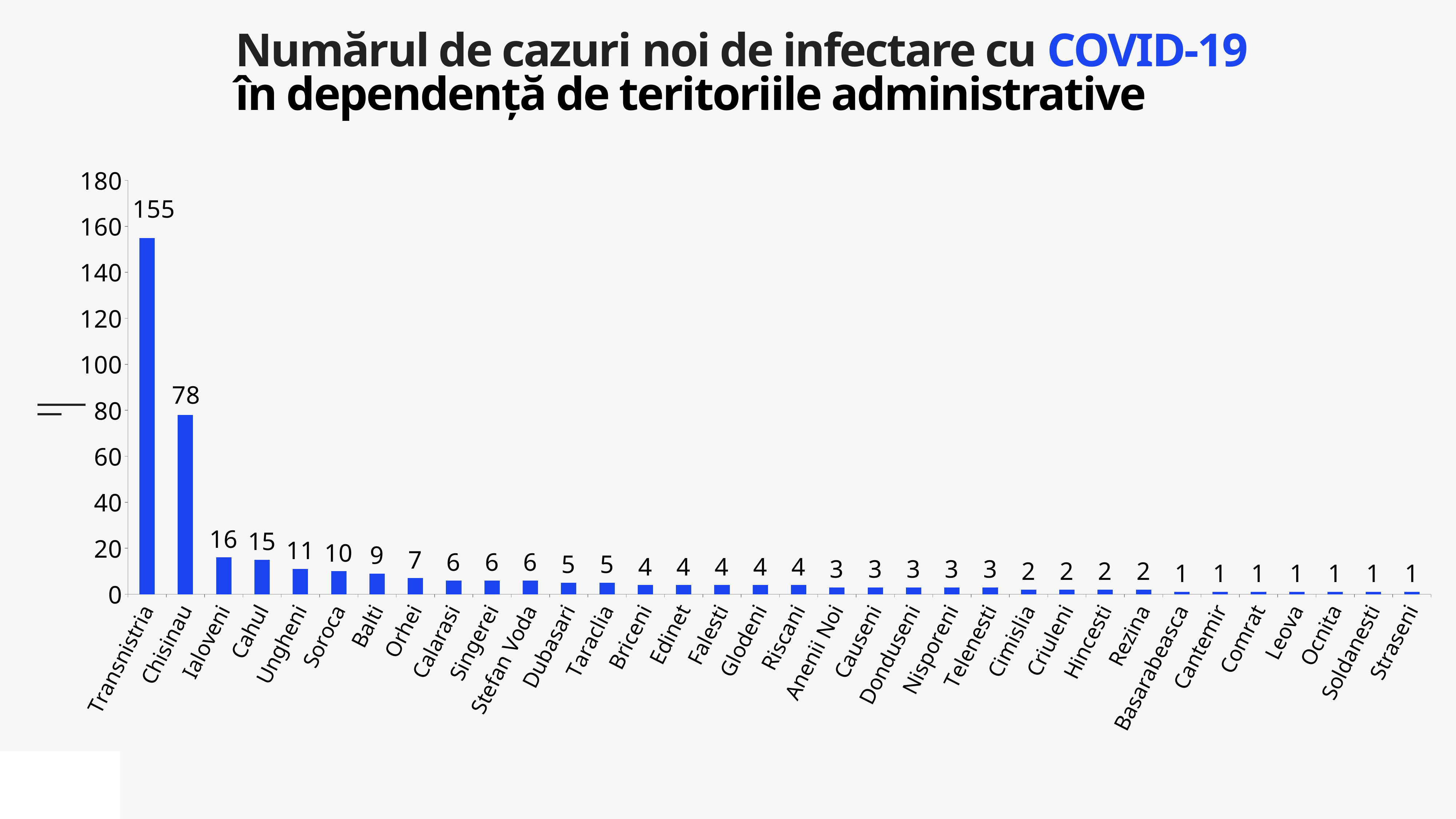
What kind of chart is shown on the slide? bar chart How many territories are shown on the x axis? 34 What is the value for Ialoveni? 16 What is the value for Balti? 9 How many new cases are shown for Chisinau? 78 How many new cases are shown for Transnistria? 155 Is the value for Chisinau greater or less than 100? less Do the values rise or fall from left to right along the x axis? fall What is the difference between the values for Transnistria and Chisinau? 77 Which has more new cases, Soroca or Orhei? Soroca Which territory has the highest number of new COVID-19 cases? Transnistria What is the difference between the values for Cahul and Ungheni? 4